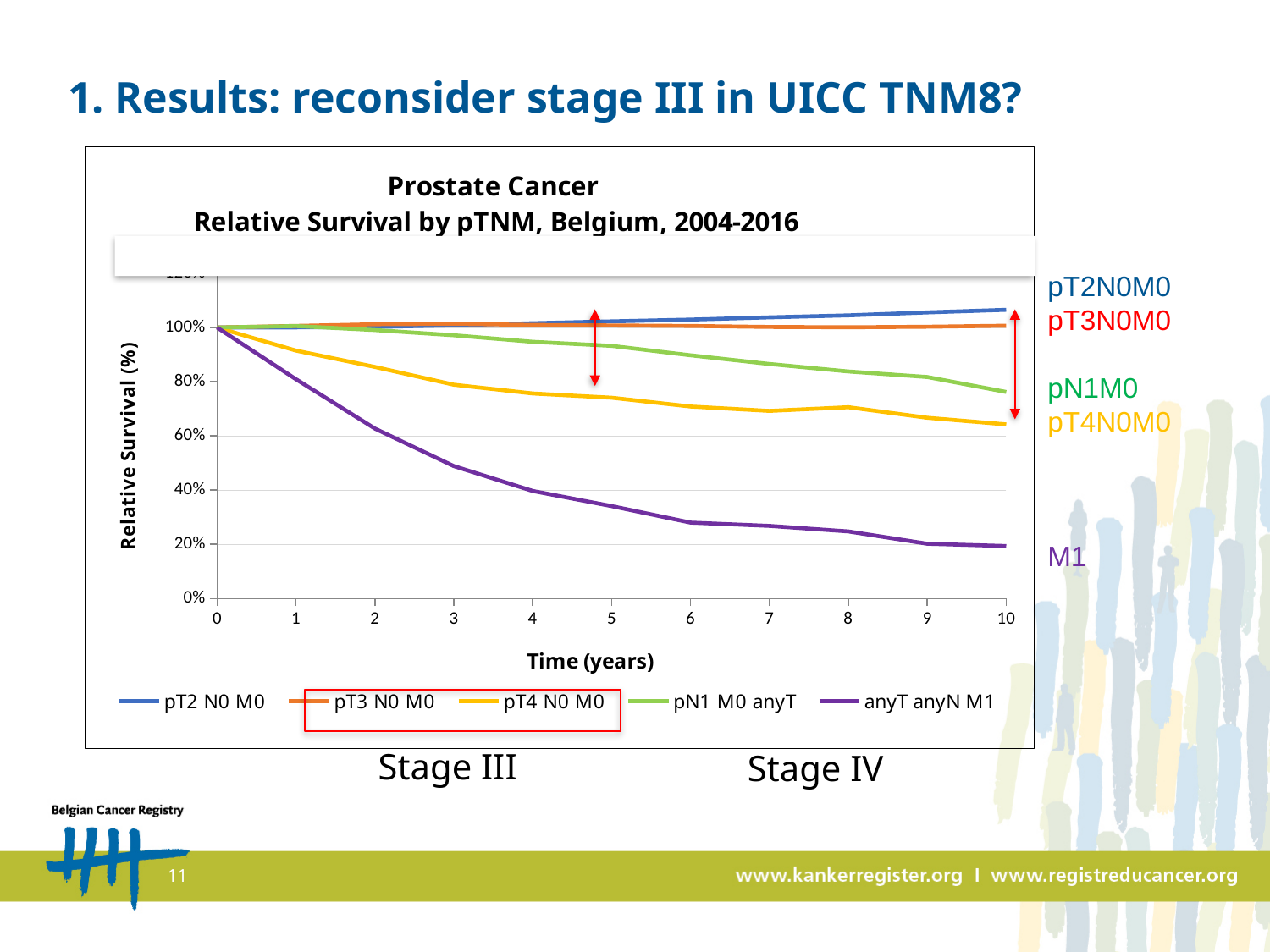
At 10 years, which series has higher relative survival: pN1 M0 anyT or pT4 N0 M0? pN1 M0 anyT What is the title of the chart? Prostate Cancer Relative Survival by pTNM, Belgium, 2004-2016 What kind of chart is shown on the slide? Line chart Is the relative survival for anyT anyN M1 at 5 years greater or less than 40%? less Which series has the lowest relative survival at 10 years? anyT anyN M1 How many series does the legend list? 5 At 10 years, which series has higher relative survival: pT2 N0 M0 or anyT anyN M1? pT2 N0 M0 Is the relative survival for pT4 N0 M0 at 10 years greater or less than 60%? greater Which series has the highest relative survival at 10 years? pT2 N0 M0 Is the relative survival for pN1 M0 anyT at 10 years greater or less than 80%? less Does the relative survival for anyT anyN M1 rise or fall over time? Fall Which two legend entries are outlined by the red box labelled Stage III? pT3 N0 M0 and pT4 N0 M0